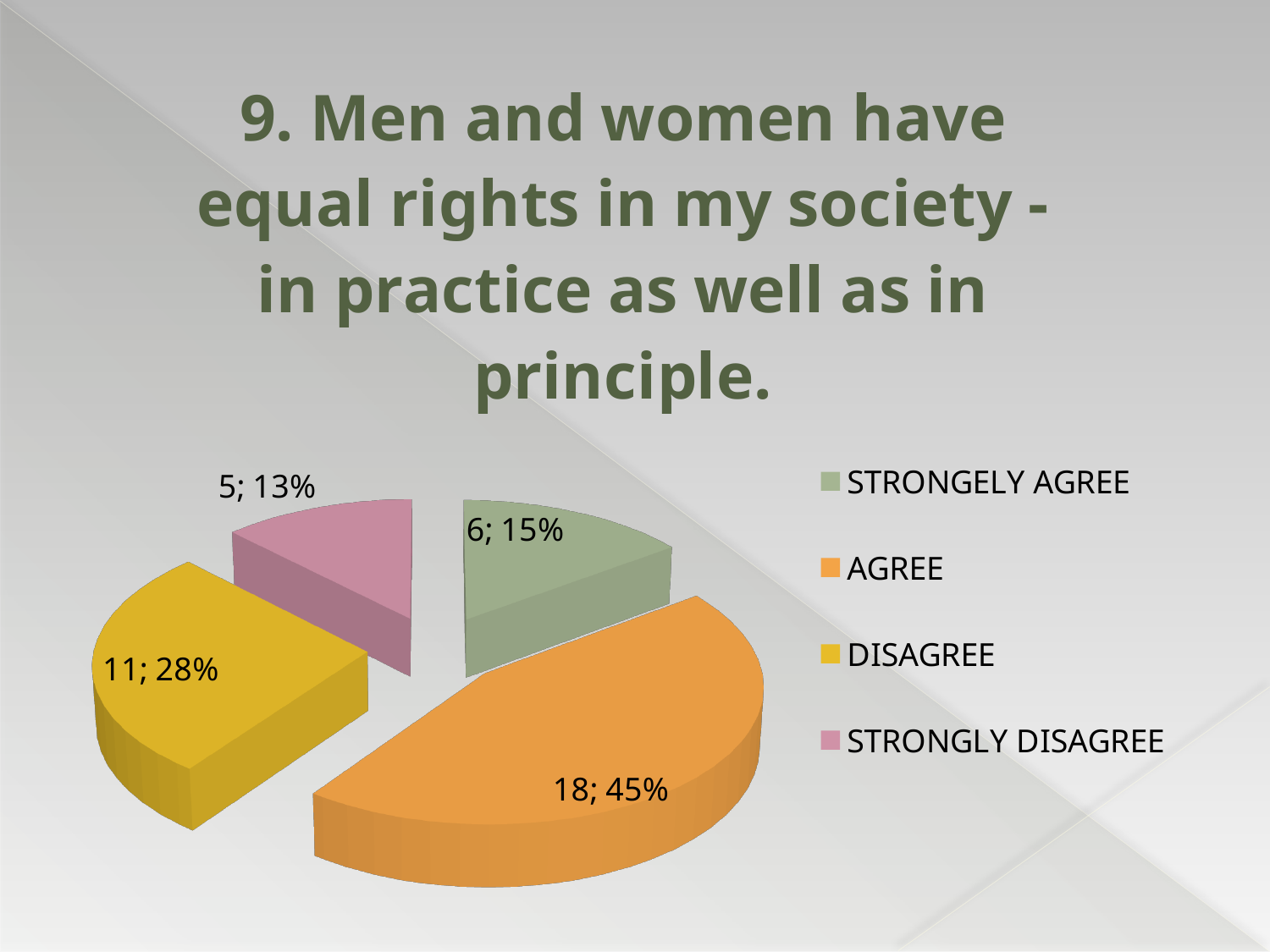
What kind of chart is shown on the slide? pie chart What percentage share does STRONGLY AGREE have? 15% How many respondents chose STRONGLY DISAGREE? 5 How many respondents chose AGREE? 18 What colour is the AGREE slice? orange Which is larger, STRONGLY AGREE or STRONGLY DISAGREE? STRONGLY AGREE How many categories does the pie chart have? 4 Which category has the smallest slice? STRONGLY DISAGREE What is the total number of respondents across all slices? 40 What is the difference in count between AGREE and DISAGREE? 7 Which category has the largest slice? AGREE What percentage share does DISAGREE have? 28%